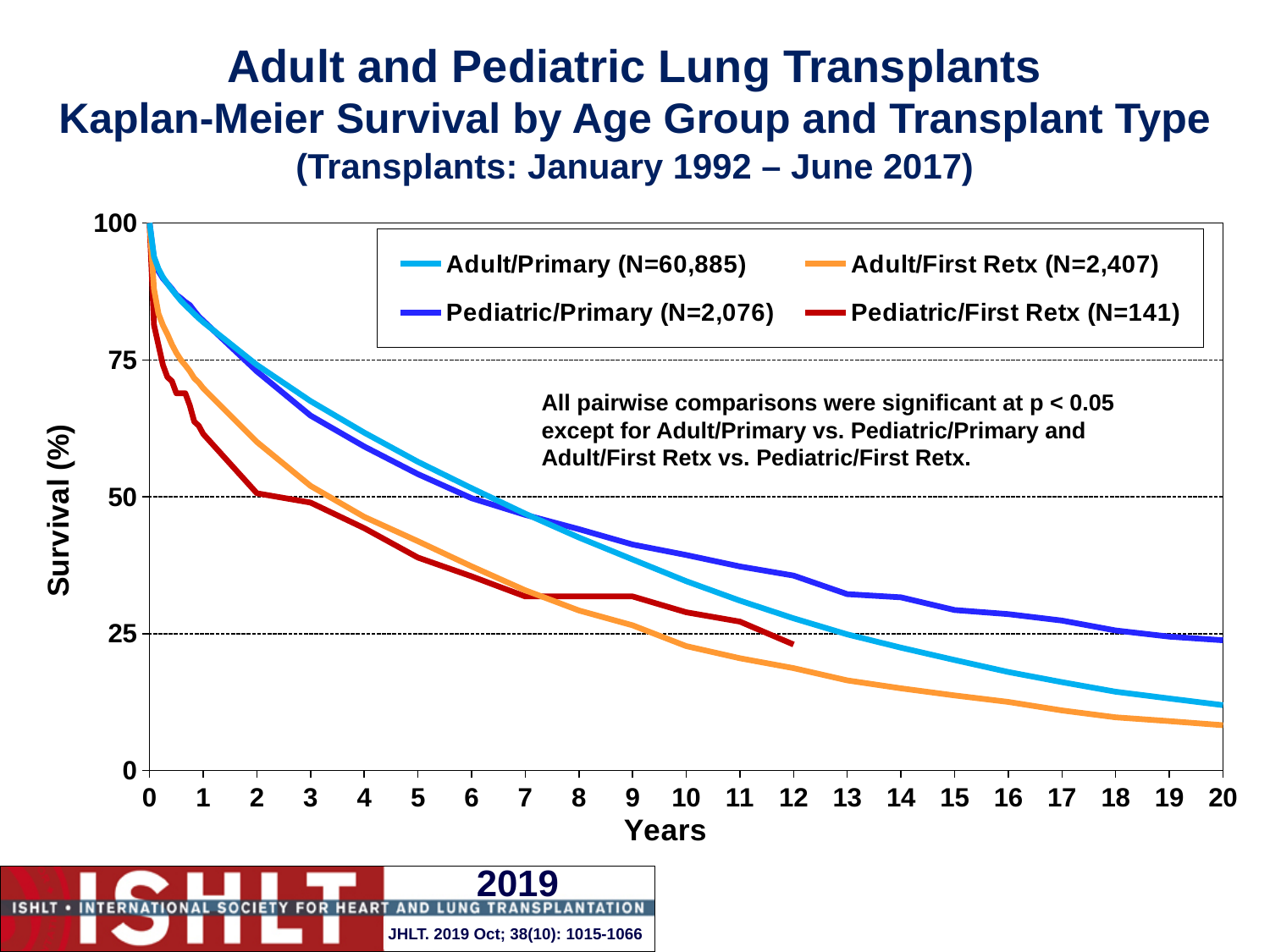
What is the N for the Pediatric/First Retx group shown in the legend? 141 Does survival rise or fall as the number of years increases? fall What kind of chart is shown on the slide? line chart Is the Adult/Primary survival at 20 years greater or less than 25? less Is the Adult/Primary survival at 10 years greater or less than 50? less What is the N for the Adult/Primary group shown in the legend? 60,885 Is the Pediatric/First Retx survival at 1 year greater or less than 50? greater At 15 years, which has higher survival: Adult/Primary or Pediatric/Primary? Pediatric/Primary How many series does the legend list? 4 At 1 year, which has higher survival: Adult/Primary or Pediatric/First Retx? Adult/Primary